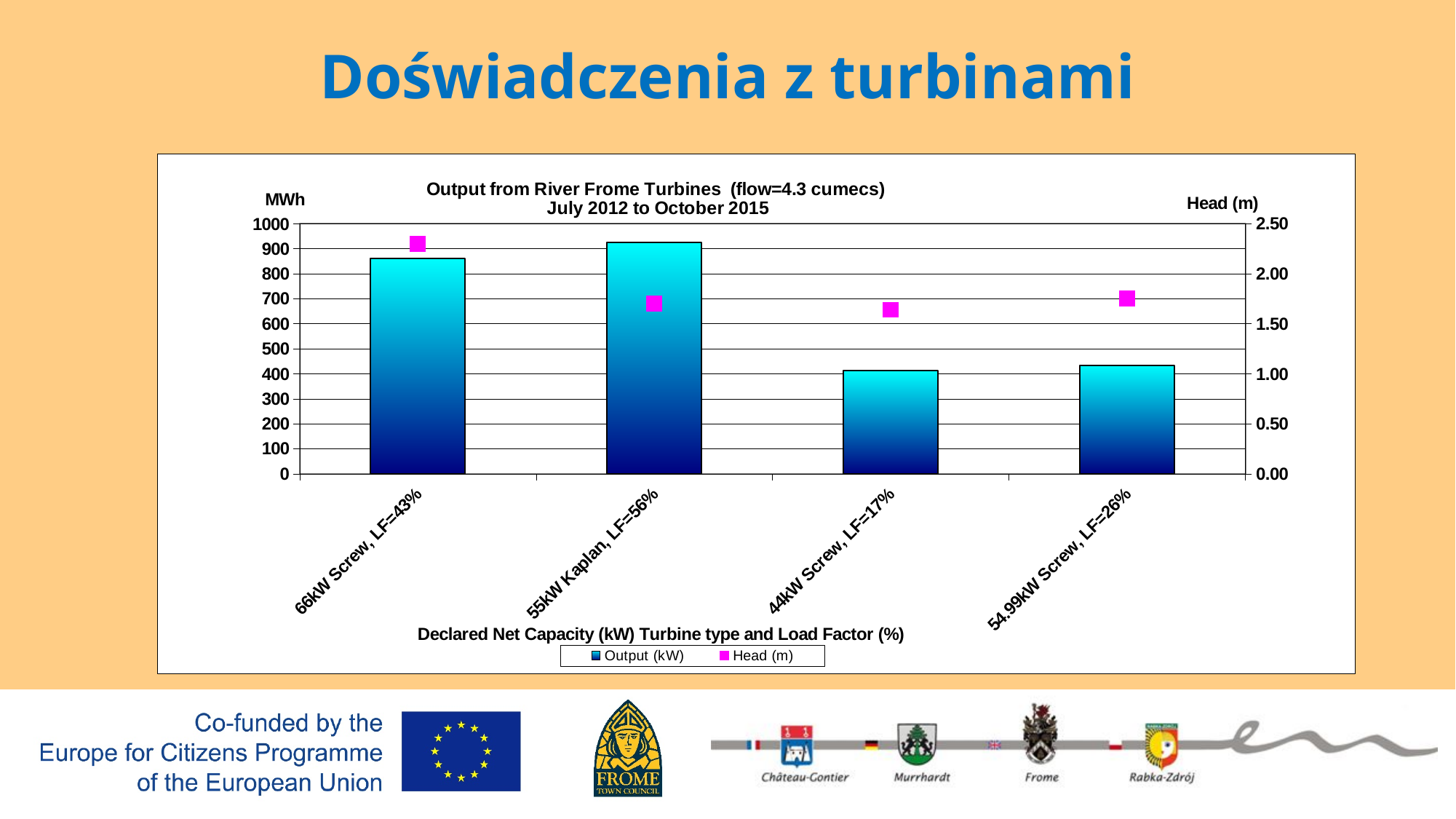
Which turbine has the highest output bar? 55kW Kaplan, LF=56% Which has the larger output bar, the 66kW Screw (LF=43%) or the 55kW Kaplan (LF=56%)? 55kW Kaplan, LF=56% Is the Head (m) value for the 44kW Screw, LF=17% greater or less than 2.00? less How many series does the legend list? 2 Is the Head (m) value for the 66kW Screw, LF=43% greater or less than 2.00? greater How many turbine categories are shown on the x axis? 4 Which turbine has the highest Head (m) marker? 66kW Screw, LF=43% Is the output value for the 66kW Screw, LF=43% greater or less than 800 MWh? greater What are the two series named in the legend? Output (kW) and Head (m) What kind of chart is shown on the slide? Bar chart